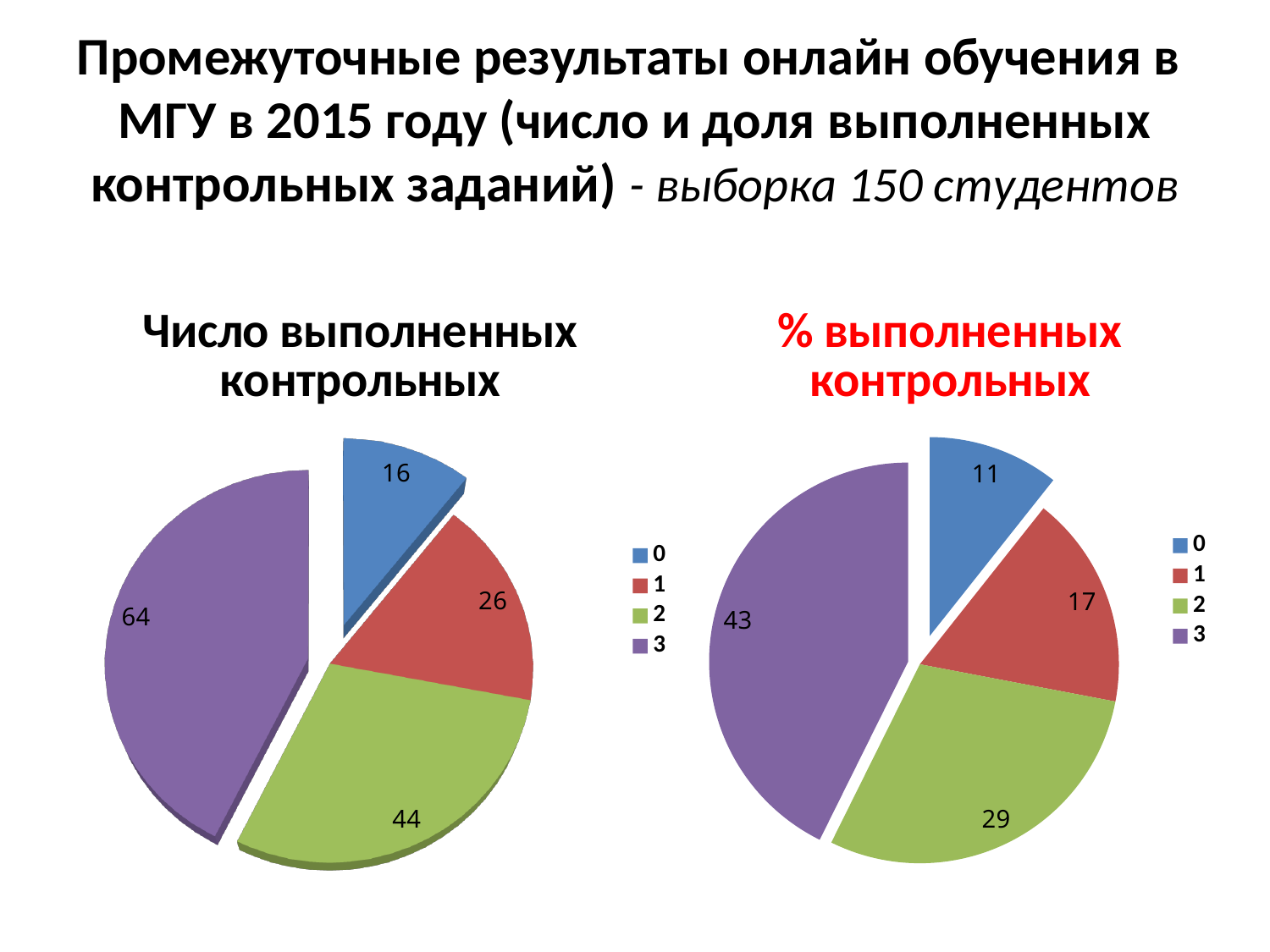
In the left chart 'Число выполненных контрольных', which category has the largest slice? 3 In the right chart '% выполненных контрольных', which category has the smallest slice? 0 In the left chart 'Число выполненных контрольных', which is larger: the value for category 1 or the value for category 2? category 2 In the right chart '% выполненных контрольных', what is the value for category 3? 43 In the left chart 'Число выполненных контрольных', what is the value for category 2? 44 In the left chart 'Число выполненных контрольных', what is the difference between the values for category 3 and category 1? 38 What type of chart is the right chart '% выполненных контрольных'? pie chart What is the total of all slices in the left chart 'Число выполненных контрольных'? 150 How many slices does the left chart 'Число выполненных контрольных' have? 4 In the right chart '% выполненных контрольных', what is the difference between the values for category 2 and category 0? 18 In the right chart '% выполненных контрольных', what is the value for category 1? 17 In the left chart 'Число выполненных контрольных', what is the value for category 0? 16